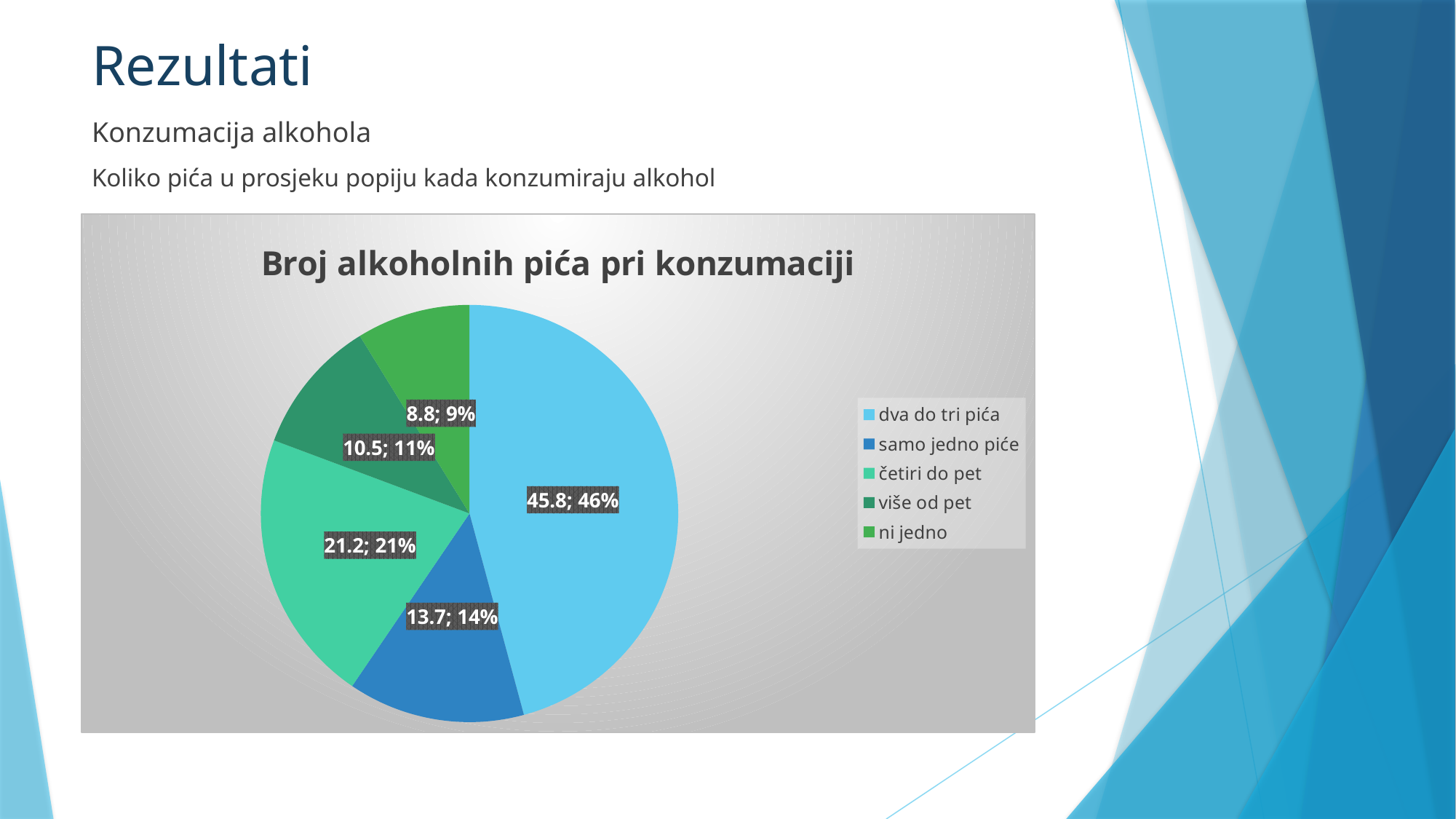
What type of chart is shown on the slide? pie chart How many slices does the pie chart have? 5 What value is shown for the slice 'četiri do pet'? 21.2 What is the title of the chart? Broj alkoholnih pića pri konzumaciji Which is larger, the value for 'više od pet' or the value for 'ni jedno'? više od pet What value is shown for the slice 'dva do tri pića'? 45.8 What value is shown for the slice 'više od pet'? 10.5 What percentage share of the pie does 'ni jedno' have? 9% Which category has the smallest slice of the pie? ni jedno What value is shown for the slice 'samo jedno piće'? 13.7 Which category has the largest slice of the pie? dva do tri pića What is the difference between the values for 'četiri do pet' and 'samo jedno piće'? 7.5